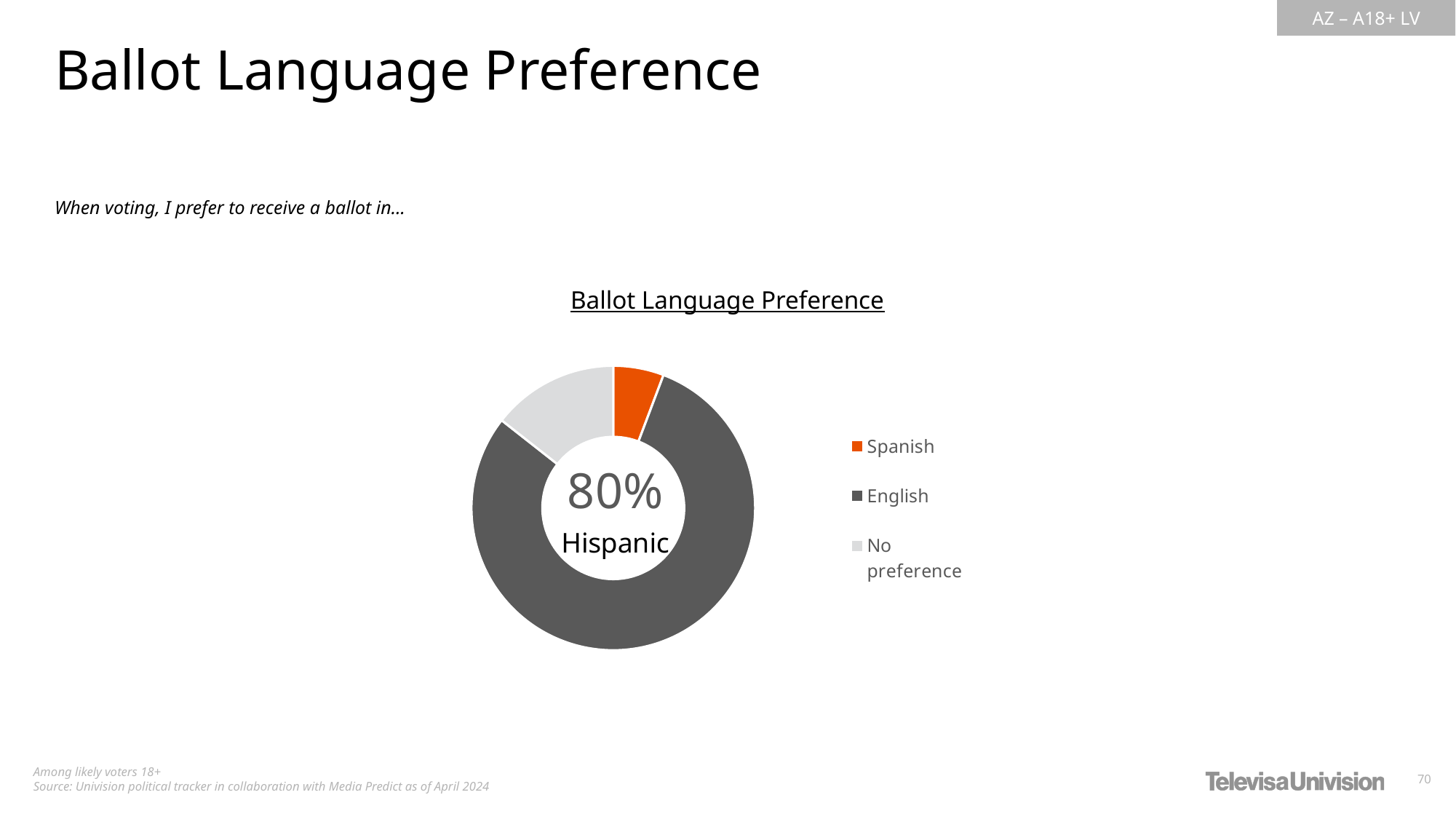
What kind of chart is shown on the slide? pie chart (donut) Which category has the smallest slice in the Ballot Language Preference chart? Spanish What colour is used for the Spanish slice? orange How many entries does the legend of the chart list? 3 How many categories does the Ballot Language Preference chart show? 3 Which slice is larger, Spanish or No preference? No preference What is the title of the chart? Ballot Language Preference Which slice is larger, English or No preference? English What percentage is printed in the centre of the donut chart? 80% Which category has the largest slice in the Ballot Language Preference chart? English